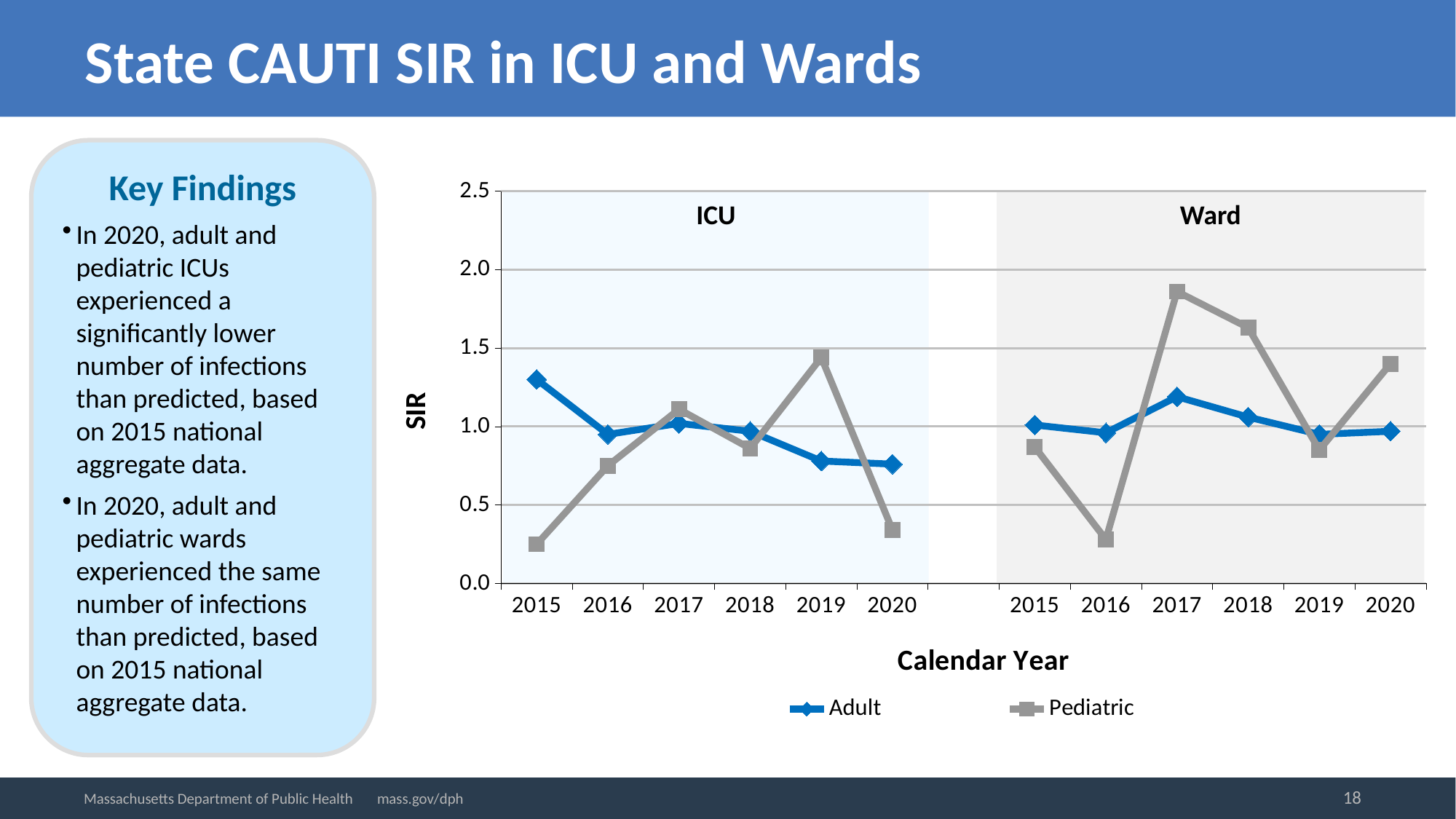
In the Ward panel, is the Pediatric SIR for 2017 greater or less than 1.5? greater How many series does the chart's legend list? 2 In the ICU panel for 2020, which series has the larger SIR, Adult or Pediatric? Adult In the Ward panel, which year has the lowest Pediatric SIR? 2016 What kind of chart is shown on the slide? Line chart What are the two series named in the chart's legend? Adult and Pediatric In the ICU panel, is the Pediatric SIR for 2015 greater or less than 0.5? less What is the label on the chart's vertical axis? SIR How many calendar years are plotted in the ICU panel of the chart? 6 In the ICU panel, which year has the highest Adult SIR? 2015 In the Ward panel, which year has the highest Pediatric SIR? 2017 In the ICU panel, is the Pediatric SIR for 2019 greater or less than 1.0? greater